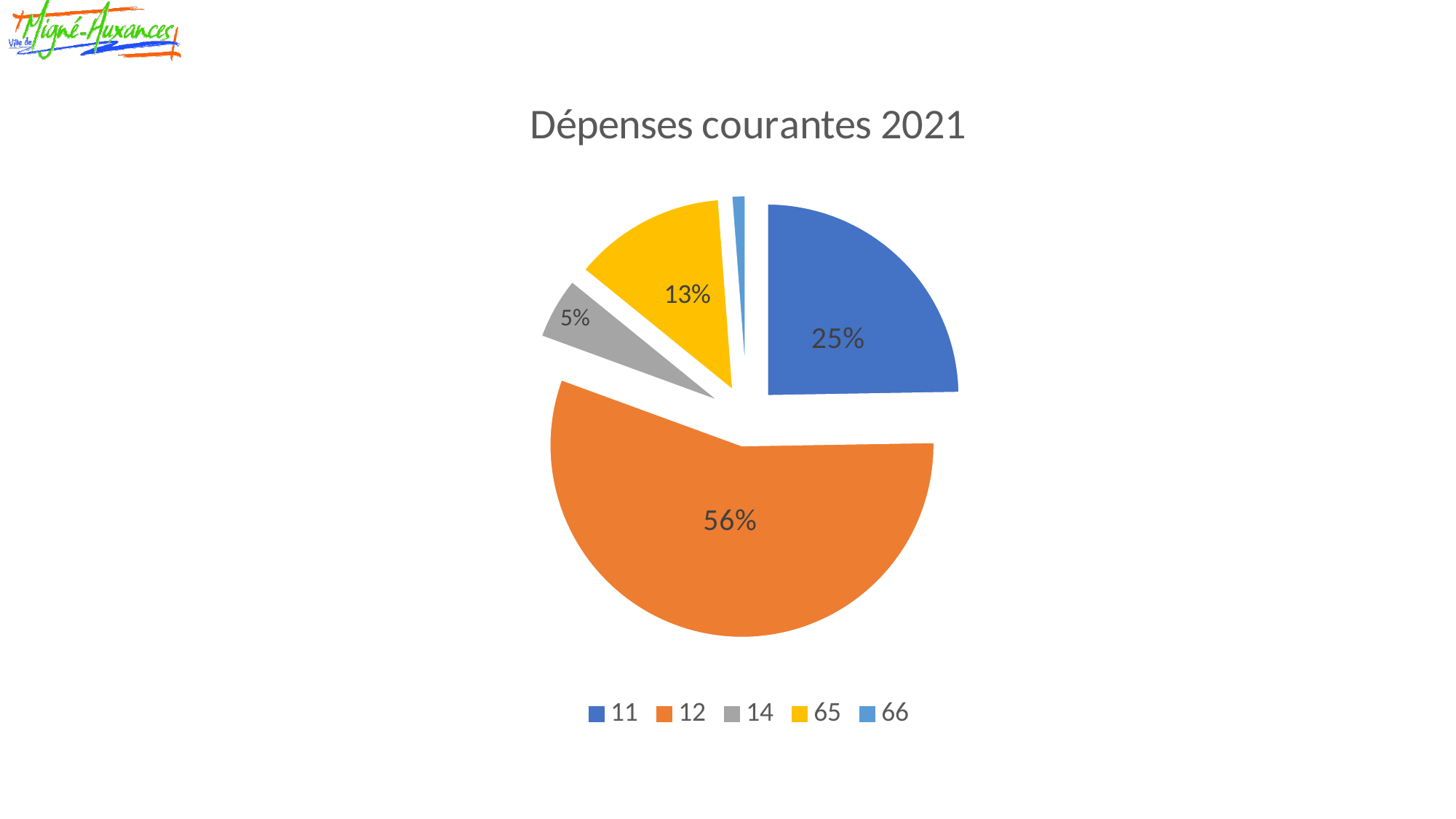
What colour is the slice for category 12? Orange What is the difference in percentage points between category 12 and category 11? 31 percentage points Which is larger, the slice for category 65 or the slice for category 14? 65 How many categories does the pie chart show? 5 What is the value shown for category 65? 13% Which category has the smallest slice of the pie? 66 What is the value shown for category 14? 5% What is the title of the chart? Dépenses courantes 2021 What share of the pie does category 12 represent? 56% What kind of chart is shown on the slide? Pie chart What is the value shown for category 11? 25% Which category has the largest slice of the pie? 12